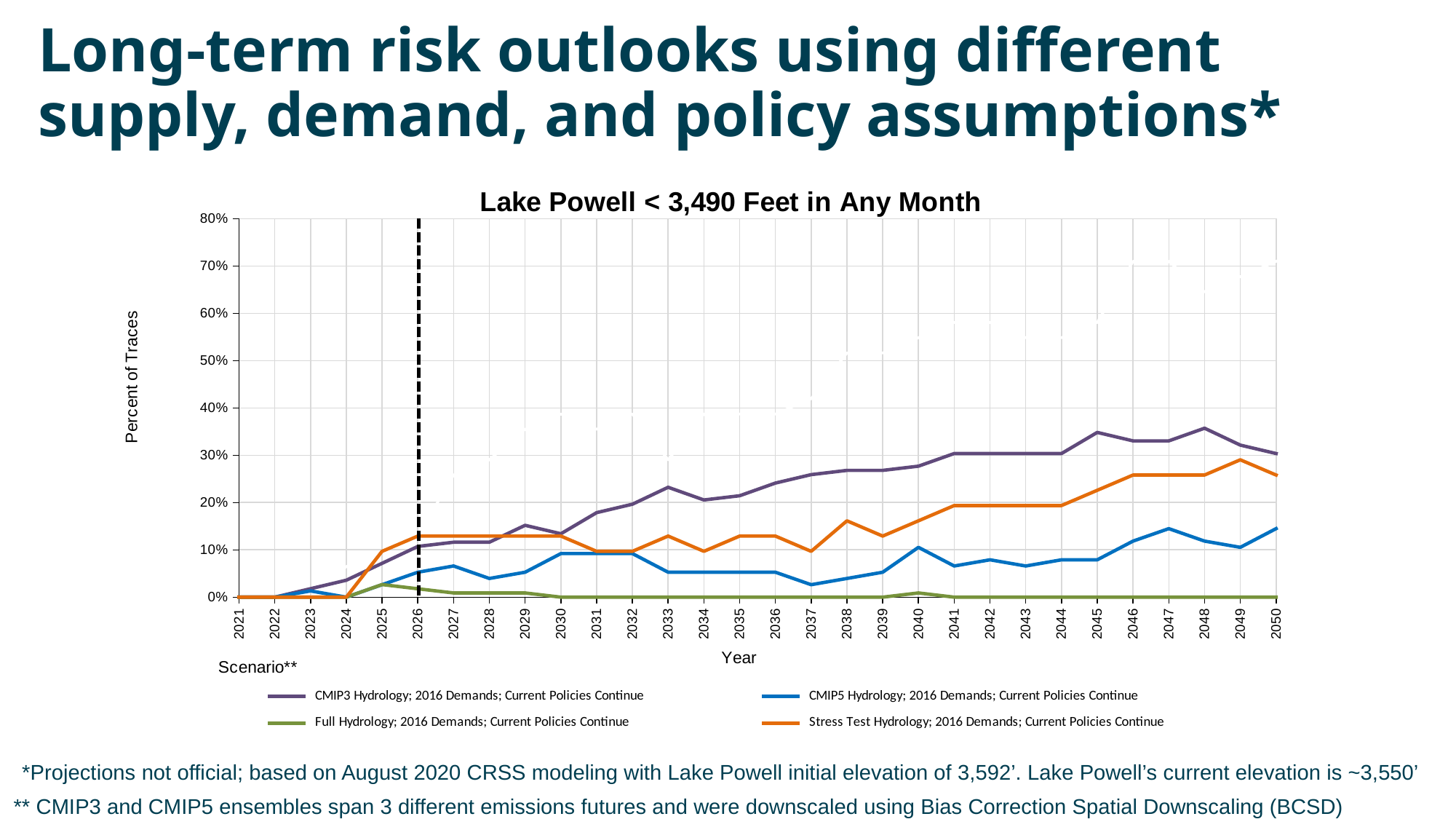
Which series has the highest value in 2050? CMIP3 Hydrology; 2016 Demands; Current Policies Continue What is the title of the chart? Lake Powell < 3,490 Feet in Any Month How many series does the legend list? 4 In 2040, which is larger: the value for CMIP5 Hydrology; 2016 Demands; Current Policies Continue or the value for Stress Test Hydrology; 2016 Demands; Current Policies Continue? Stress Test Hydrology; 2016 Demands; Current Policies Continue How many years are shown along the x axis? 30 Does the CMIP3 Hydrology; 2016 Demands; Current Policies Continue series generally rise or fall from 2021 to 2050? rise Is the value for CMIP3 Hydrology; 2016 Demands; Current Policies Continue in 2045 greater or less than 30%? greater Is the value for CMIP5 Hydrology; 2016 Demands; Current Policies Continue in 2050 greater or less than 20%? less Is the value for Stress Test Hydrology; 2016 Demands; Current Policies Continue in 2050 greater or less than 20%? greater What is the label on the vertical axis? Percent of Traces Which series has the lowest value in 2050? Full Hydrology; 2016 Demands; Current Policies Continue What kind of chart is shown on the slide? line chart